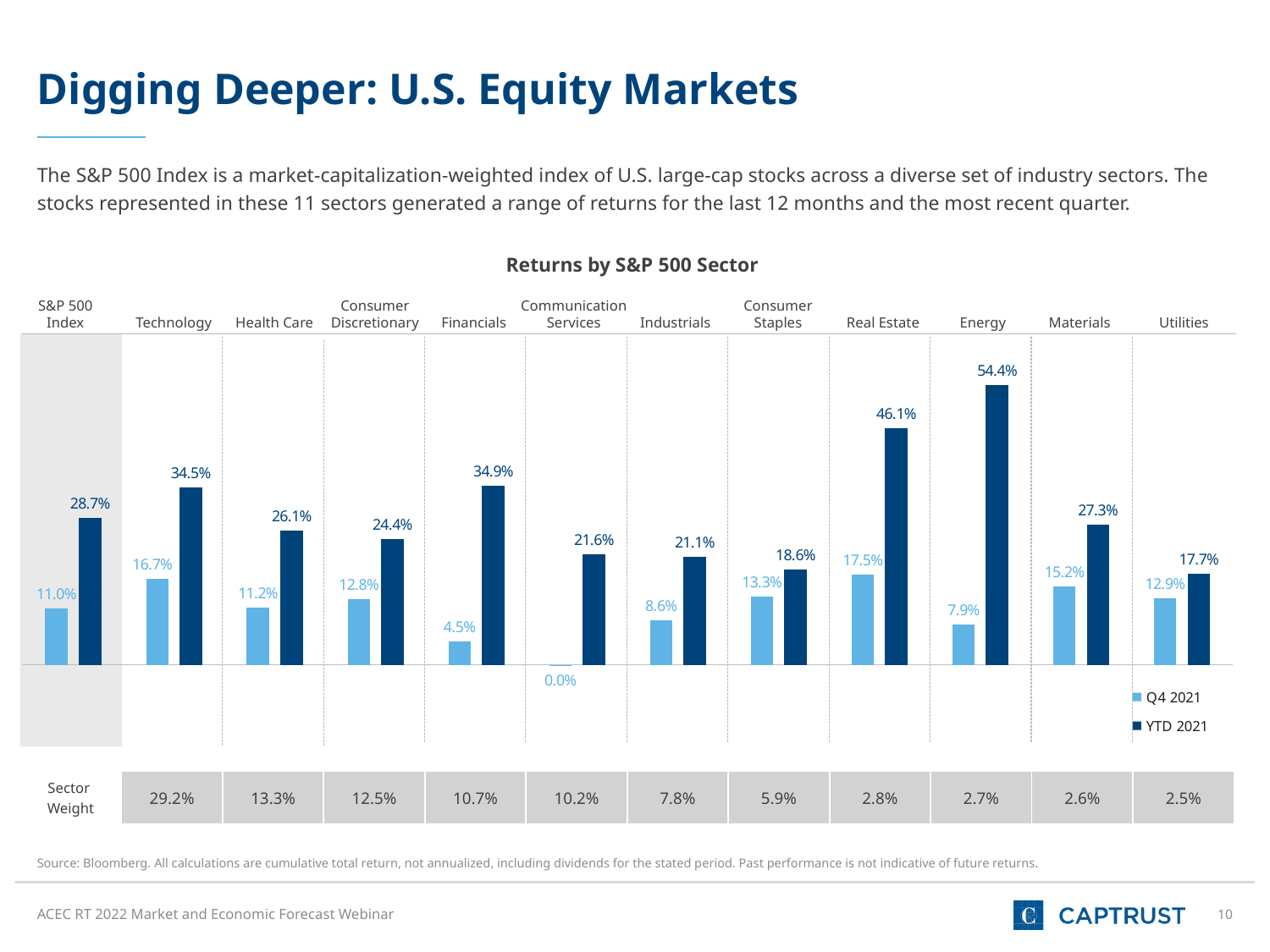
Which sector has the highest YTD 2021 return? Energy What is the title of the chart? Returns by S&P 500 Sector What kind of chart is shown? Bar chart What is the Q4 2021 return for Communication Services? 0.0% What is the Q4 2021 return for the S&P 500 Index? 11.0% What is the difference between the YTD 2021 and Q4 2021 returns for Real Estate? 28.6% How many series does the legend list? 2 Which sector has the lowest Q4 2021 return? Communication Services How many sectors (excluding the S&P 500 Index) are shown in the chart? 11 What is the sector weight shown for Technology? 29.2% Which is larger, the YTD 2021 return for Technology or for Financials? Financials What is the YTD 2021 return for Energy? 54.4%